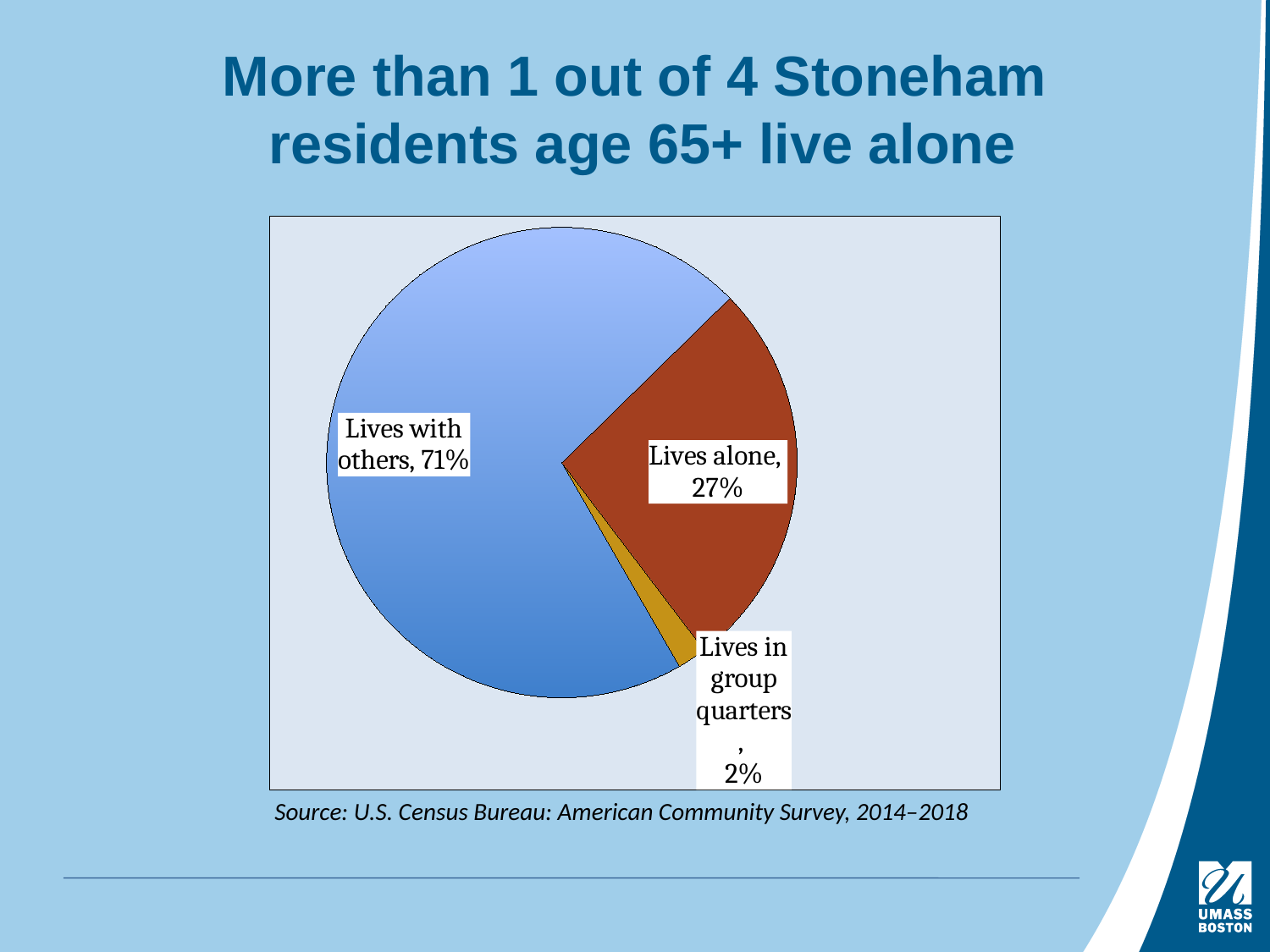
Which living arrangement has the smallest share of the pie? Lives in group quarters Which slice is larger: 'Lives alone' or 'Lives in group quarters'? Lives alone What source is cited below the chart? U.S. Census Bureau: American Community Survey, 2014–2018 What kind of chart is shown on the slide? Pie chart What share of Stoneham residents age 65+ lives with others? 71% What colour is the 'Lives alone' slice? Red What is the difference in percentage points between the 'Lives with others' and 'Lives alone' slices? 44 What share of Stoneham residents age 65+ lives in group quarters? 2% Which living arrangement has the largest share of the pie? Lives with others What share of Stoneham residents age 65+ lives alone? 27% What is the difference in percentage points between the 'Lives alone' and 'Lives in group quarters' slices? 25 How many slices does the pie chart have? 3